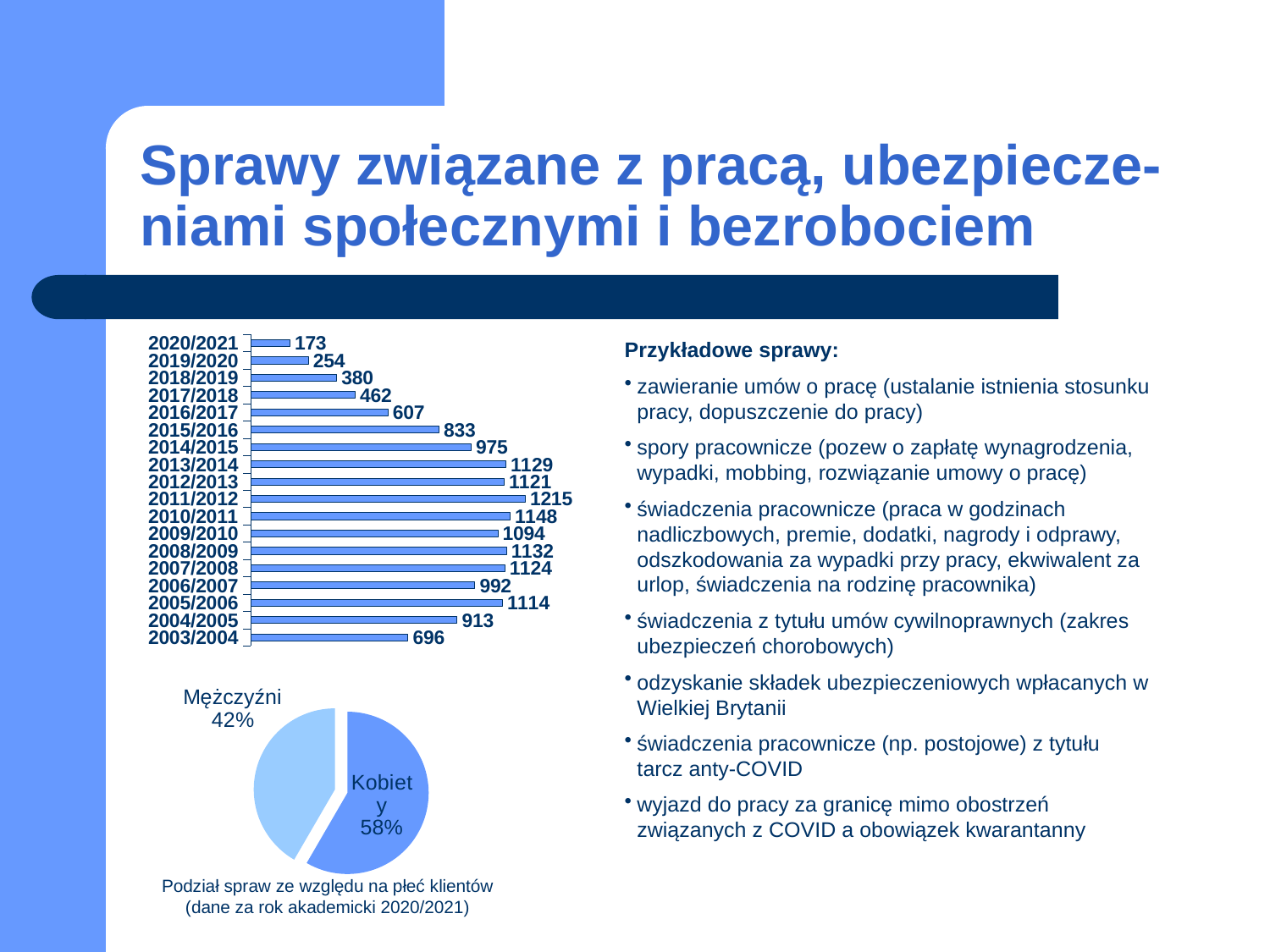
What kind of chart is the chart at the top left of the slide? bar chart In the bar chart, what is the value for 2011/2012? 1215 In the bar chart, which academic year has the lowest value? 2020/2021 In the bar chart, what is the value for 2020/2021? 173 In the bar chart, which is larger, the value for 2015/2016 or the value for 2016/2017? 2015/2016 How many academic years are shown in the bar chart? 18 In the bar chart, what is the value for 2003/2004? 696 In the bar chart, do the values rise or fall from 2016/2017 to 2020/2021? fall In the bar chart, which academic year has the highest value? 2011/2012 In the pie chart, what share of cases is for Kobiety? 58% In the pie chart, which slice is larger, Kobiety or Mężczyźni? Kobiety In the bar chart, what is the difference between the values for 2019/2020 and 2020/2021? 81